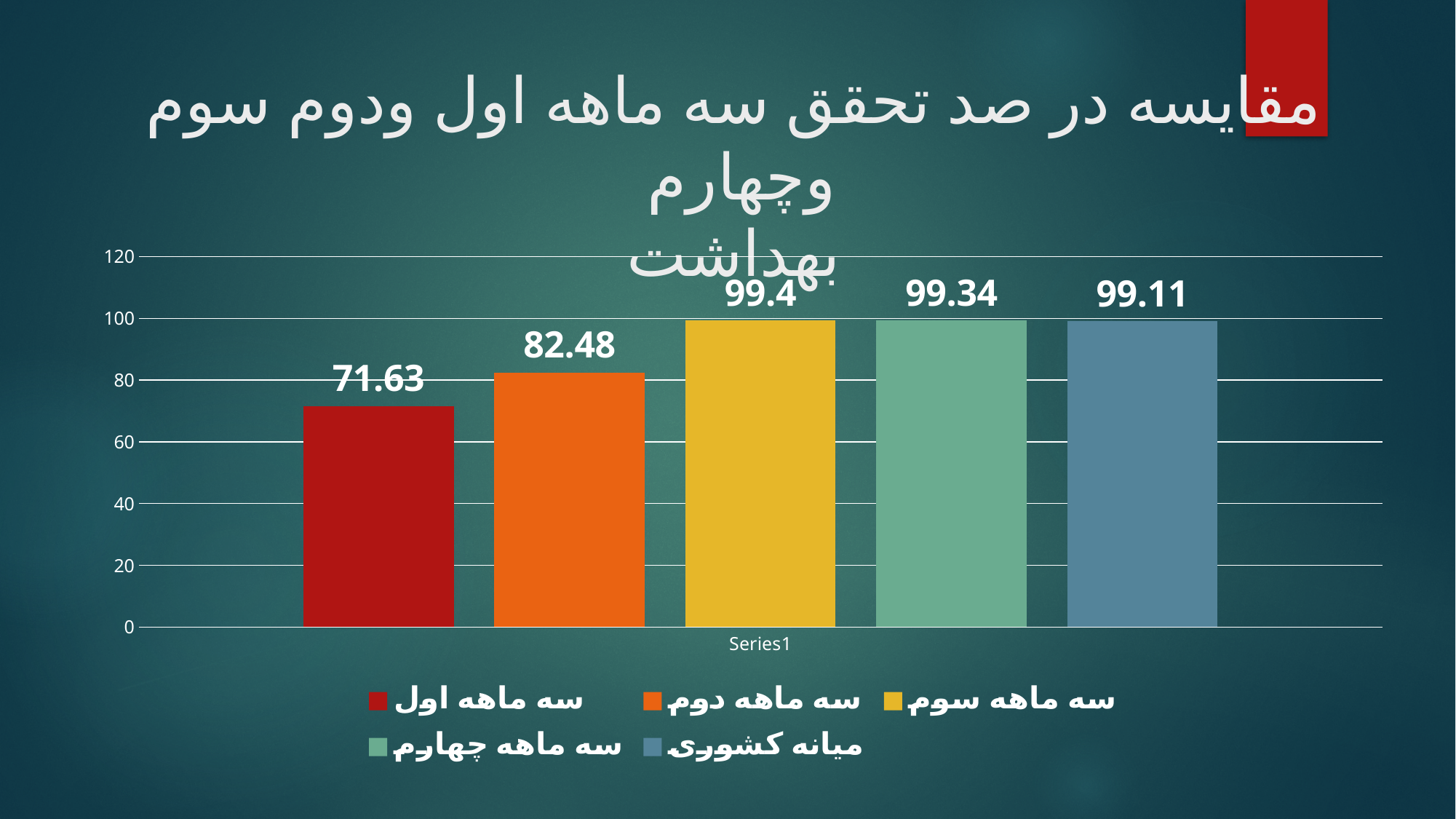
What is the value shown for میانه کشوری? 99.11 What is the value shown for سه ماهه چهارم? 99.34 Which category has the lowest value? سه ماهه اول What is the value shown for سه ماهه دوم? 82.48 Which is larger, the value for سه ماهه دوم or the value for سه ماهه اول? سه ماهه دوم Which category has the highest value according to the data labels? سه ماهه سوم How many bars are plotted in the chart? 5 What kind of chart is shown on the slide? bar chart What is the value shown for سه ماهه اول? 71.63 How many entries does the legend list? 5 Is the value for سه ماهه اول greater or less than 80? less What is the difference between the values for سه ماهه دوم and سه ماهه اول? 10.85